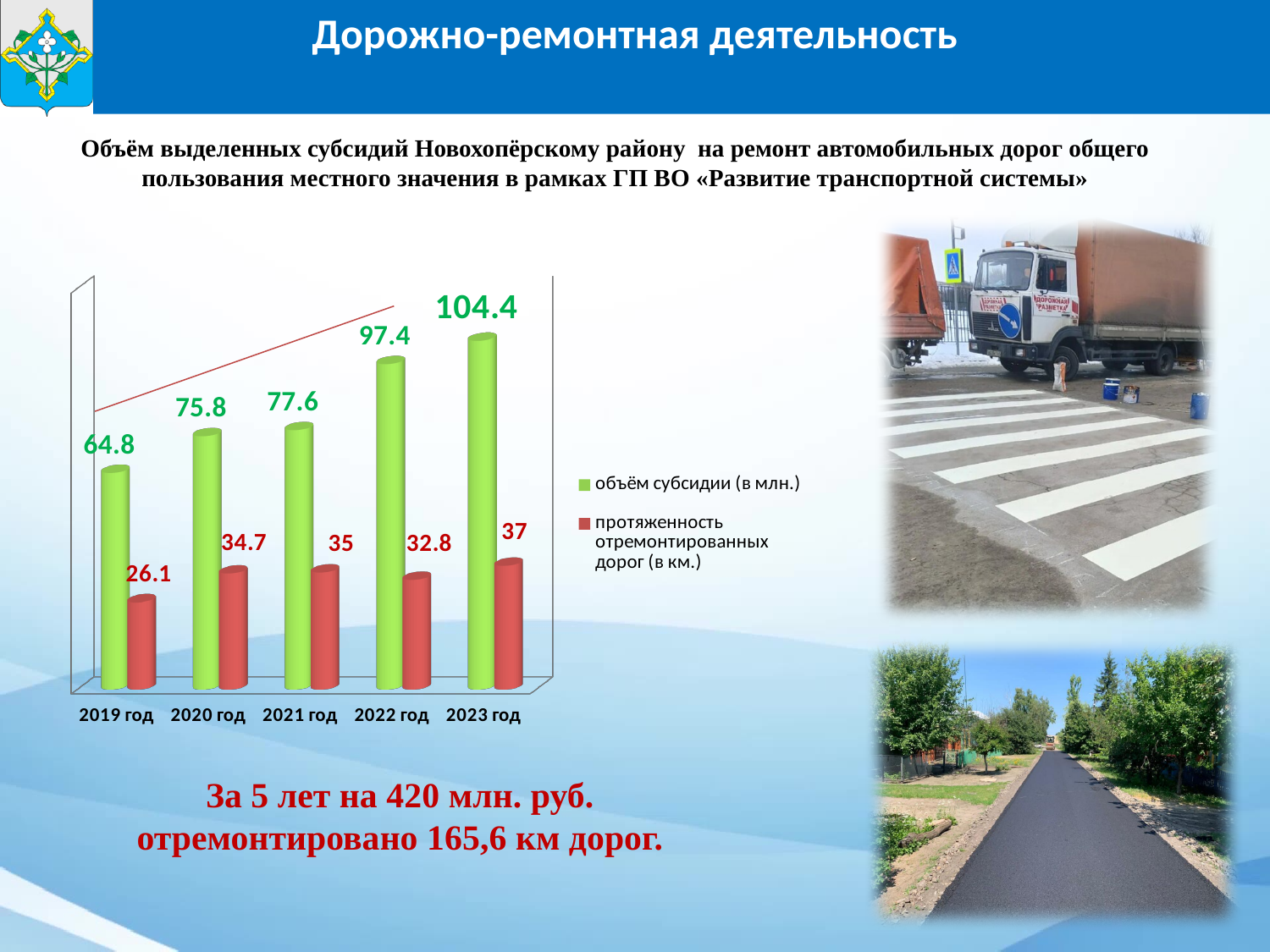
What type of chart is shown on the slide? Bar chart How many years are shown on the x axis of the chart? 5 What is the value of "объём субсидии (в млн.)" for 2021 год? 77.6 What is the value of "протяженность отремонтированных дорог (в км.)" for 2019 год? 26.1 Which is larger: "протяженность отремонтированных дорог (в км.)" for 2021 год or for 2022 год? 2021 год What is the difference between the "объём субсидии (в млн.)" values for 2023 год and 2019 год? 39.6 What colour are the bars for "объём субсидии (в млн.)"? Green Which year has the highest value of "объём субсидии (в млн.)"? 2023 год Which year has the lowest value of "протяженность отремонтированных дорог (в км.)"? 2019 год What is the value of "объём субсидии (в млн.)" for 2023 год? 104.4 Does the value of "объём субсидии (в млн.)" rise or fall from 2019 год to 2023 год? Rises How many series does the chart legend list? 2